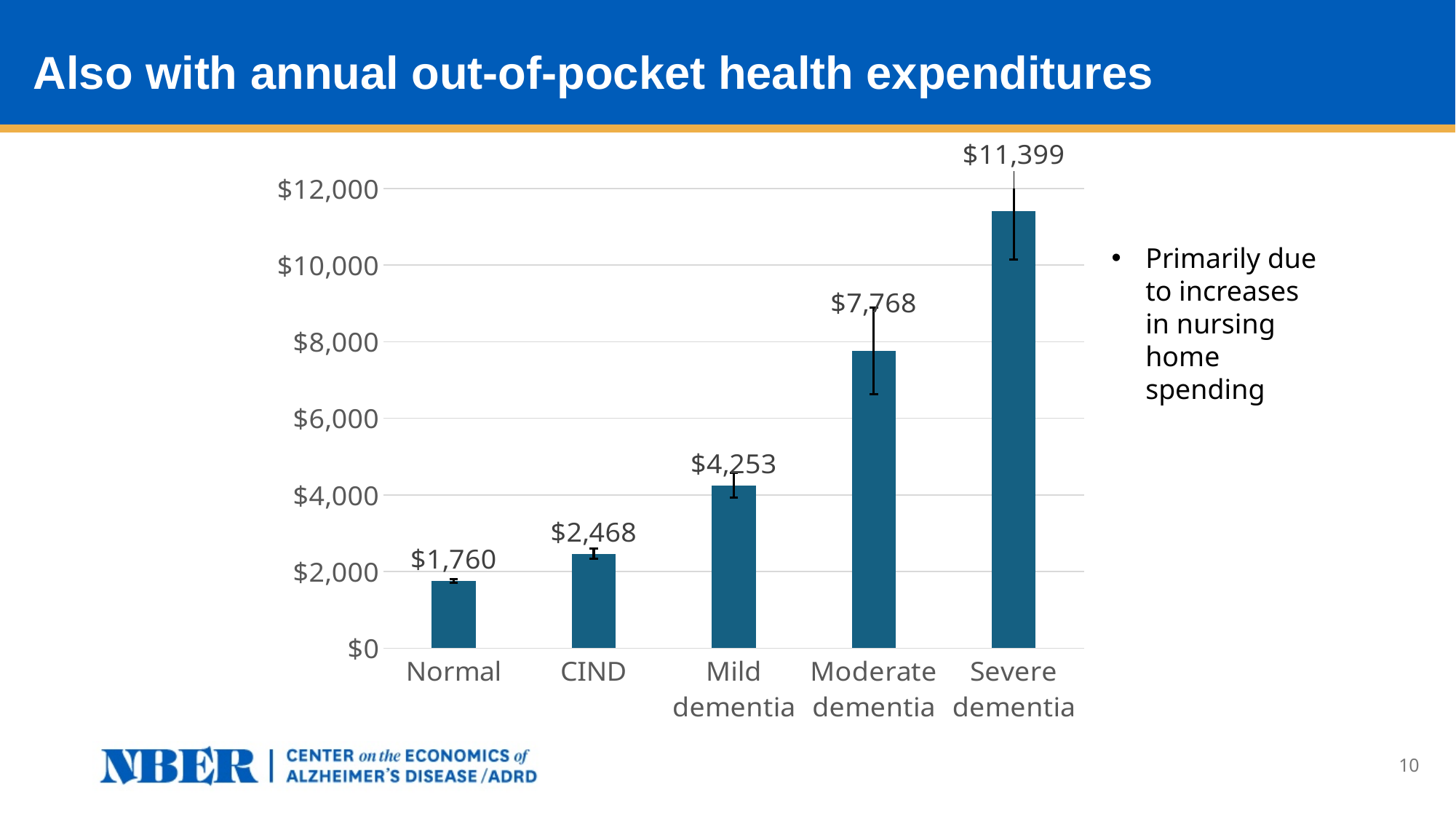
What is the value shown for Moderate dementia? $7,768 What is the annual out-of-pocket health expenditure for the Normal group? $1,760 Which is larger, the value for Mild dementia or the value for CIND? Mild dementia How many categories are shown on the x axis? 5 What kind of chart is shown on the slide? Bar chart What is the difference between the values for Mild dementia and CIND? $1,785 Is the value for Severe dementia greater or less than $10,000? greater What is the difference between the values for Severe dementia and Moderate dementia? $3,631 Which category has the highest annual out-of-pocket health expenditure? Severe dementia Which category has the lowest annual out-of-pocket health expenditure? Normal Do the values rise or fall moving from Normal to Severe dementia along the x axis? Rise What is the value shown for CIND? $2,468